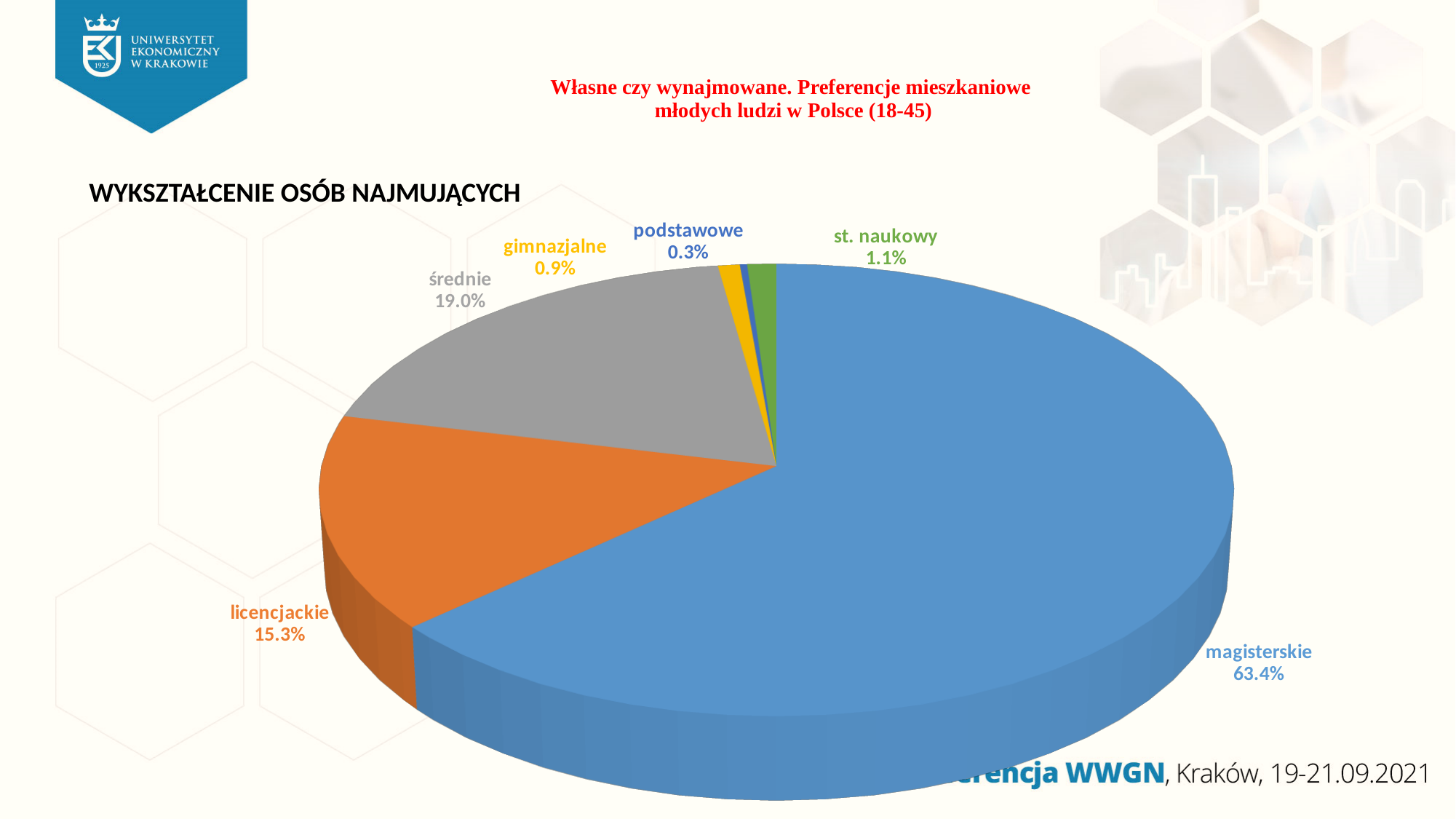
What is the difference between the 'średnie' and 'licencjackie' shares? 3.7% Which category has the smallest slice of the pie? podstawowe How many categories are shown in the pie chart? 6 What share of the pie does the 'magisterskie' slice represent? 63.4% What is the title of the chart? WYKSZTAŁCENIE OSÓB NAJMUJĄCYCH Which category has the largest slice of the pie? magisterskie What is the value shown for 'średnie'? 19.0% Which is larger, the 'gimnazjalne' slice or the 'st. naukowy' slice? st. naukowy What is the value shown for 'st. naukowy'? 1.1% What is the value shown for 'licencjackie'? 15.3% What type of chart is shown on the slide? pie chart What is the value shown for 'podstawowe'? 0.3%